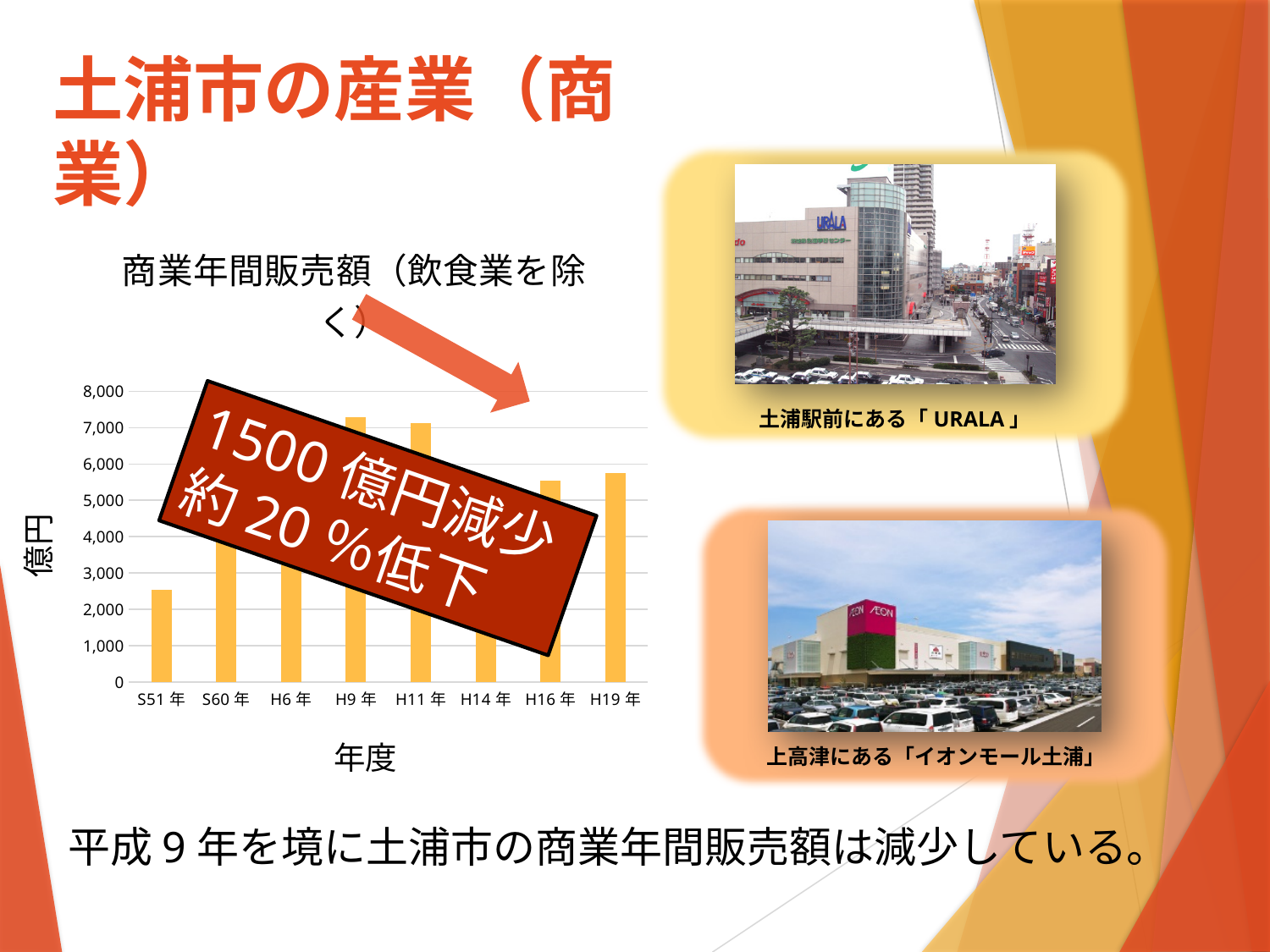
How many years (categories) are plotted on the x axis of the chart? 8 Which is larger, the value for S51年 or the value for H19年? H19年 What is the title of the chart? 商業年間販売額（飲食業を除く） Do the values rise or fall from H9年 to H16年? fall Which year has the lowest value in the chart? S51年 Is the value for H19年 greater or less than 5,000? greater Is the value for S51年 greater or less than 3,000? less What is the label of the vertical axis of the chart? 億円 What kind of chart is shown on the slide? bar chart Is the value for H16年 greater or less than 6,000? less